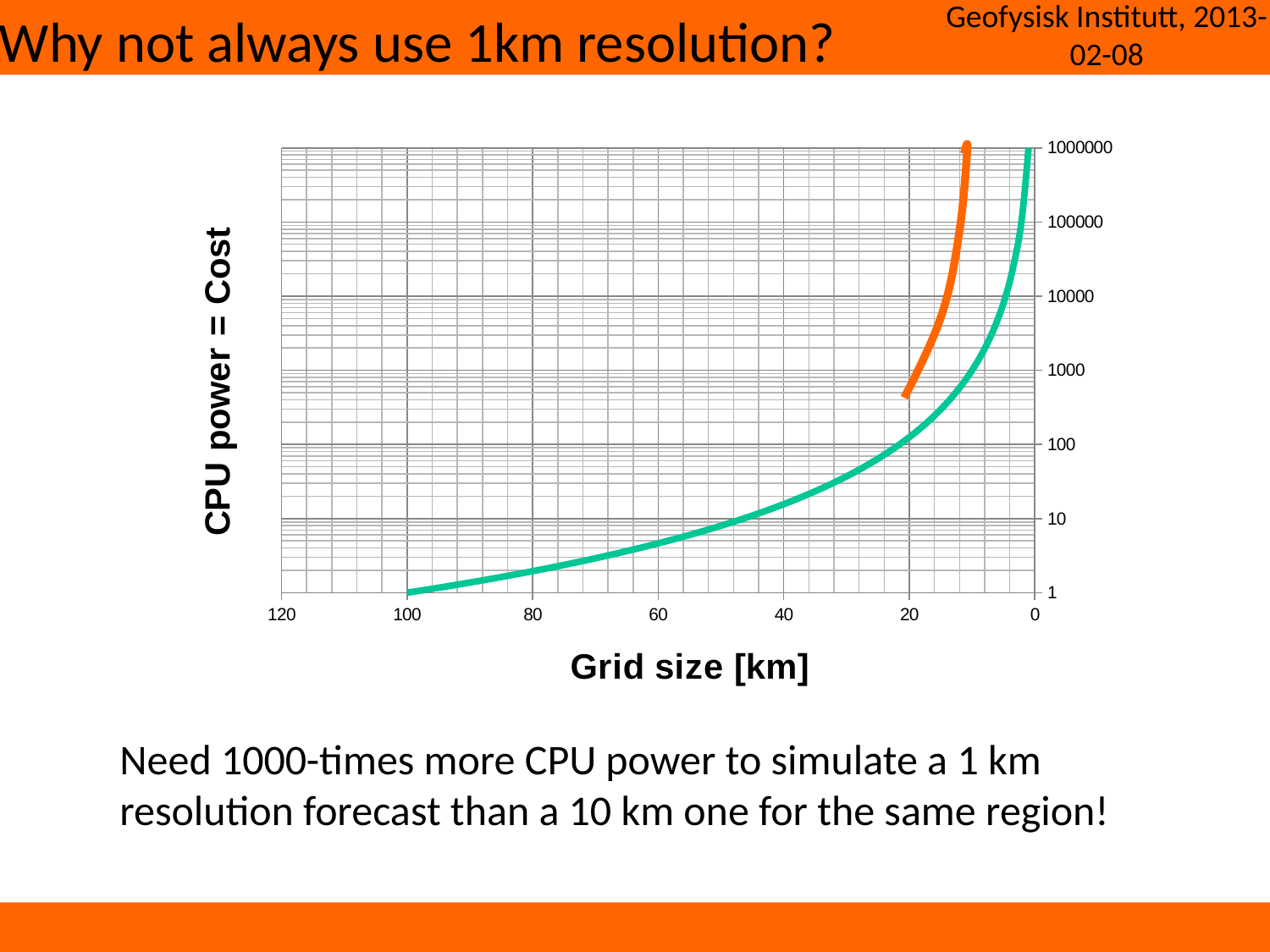
Do the plotted values rise or fall as you move from left to right along the x axis (from 120 km toward 0 km)? rise What is the title of the y axis of the chart? CPU power = Cost How many lines are plotted on the chart? 2 What kind of chart is shown on the slide? line chart What is the highest value labelled on the y axis of the chart? 1000000 Is the value of the orange line at a grid size of 20 km greater or less than 1000? less Is the value of the green line at a grid size of 60 km greater or less than 10? less At a grid size of 20 km, which line has the higher value, the orange line or the green line? orange line What is the title of the x axis of the chart? Grid size [km] Is the value of the green line at a grid size of 40 km greater or less than 100? less